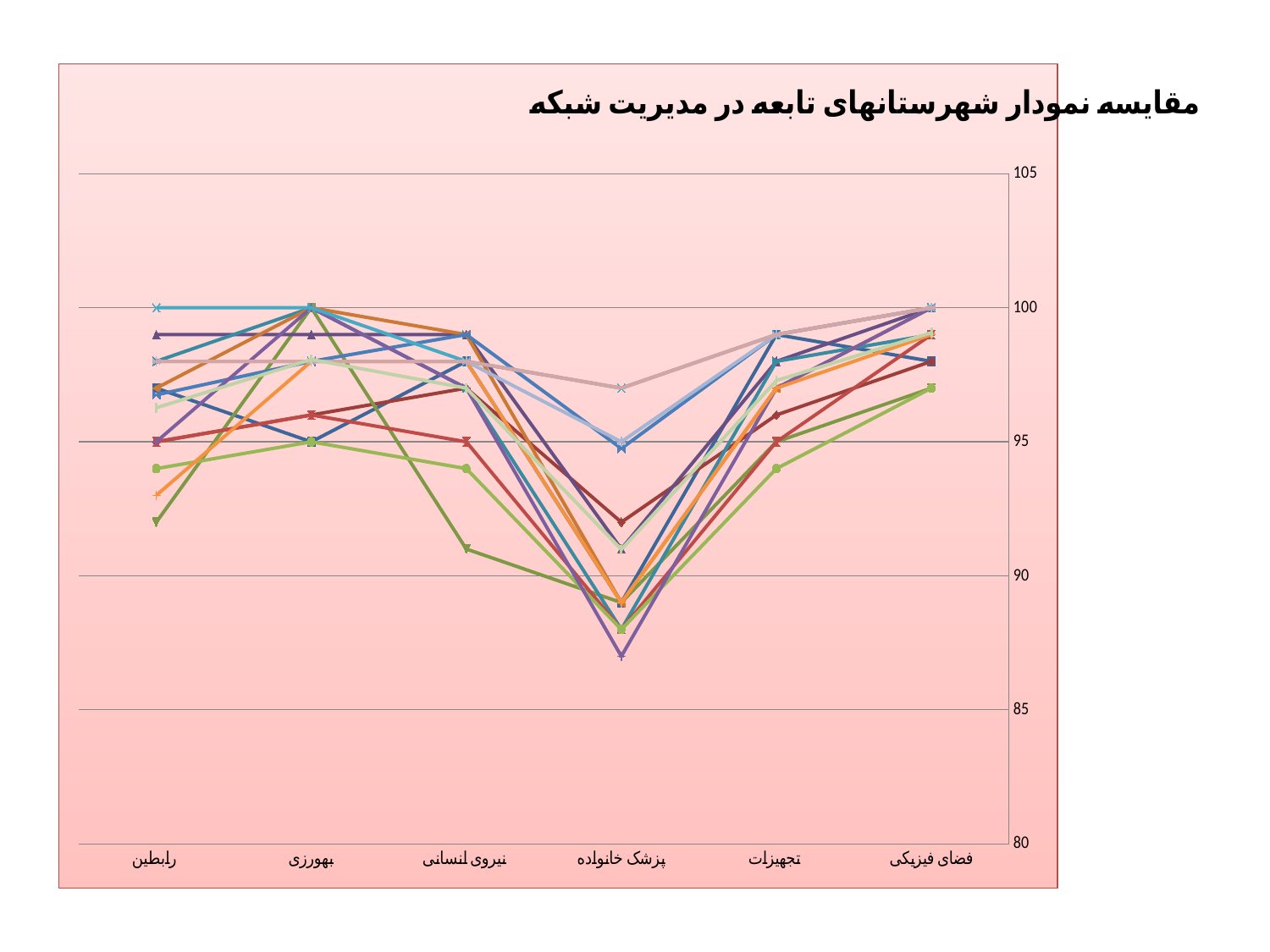
What is the highest value shown on the y axis? 105 Do the values rise or fall from پزشک خانواده to فضای فیزیکی? rise Do the values rise or fall from نیروی انسانی to پزشک خانواده? fall Is the lowest value at پزشک خانواده greater or less than 90? less What is the title of the chart? مقایسه نمودار شهرستانهای تابعه در مدیریت شبکه What kind of chart is shown on the slide? line chart Is the highest value at پزشک خانواده greater or less than 100? less At which category do the lines dip to their lowest values? پزشک خانواده Is the lowest value at رابطین greater or less than 90? greater How many categories are shown along the x axis? 6